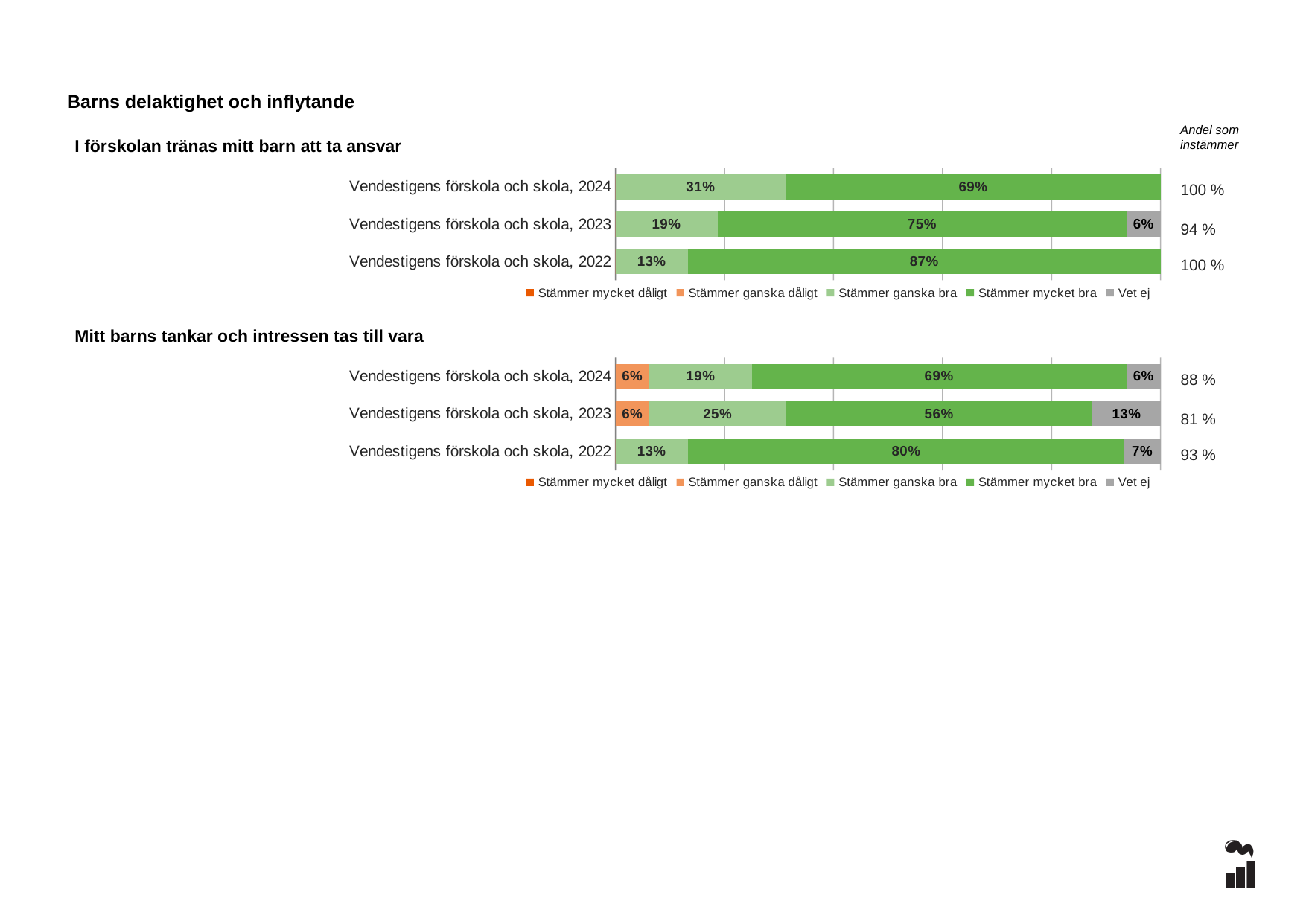
How many series does the legend of the chart 'I förskolan tränas mitt barn att ta ansvar' list? 5 In the chart 'I förskolan tränas mitt barn att ta ansvar', what is the 'Vet ej' value for Vendestigens förskola och skola, 2023? 6% In the chart 'Mitt barns tankar och intressen tas till vara', what is the 'Andel som instämmer' for Vendestigens förskola och skola, 2023? 81 % What kind of chart is 'Mitt barns tankar och intressen tas till vara'? Stacked bar chart In the chart 'Mitt barns tankar och intressen tas till vara', which year has the lowest 'Stämmer mycket bra' value? 2023 In the chart 'I förskolan tränas mitt barn att ta ansvar', what is the 'Stämmer mycket bra' value for Vendestigens förskola och skola, 2022? 87% In the chart 'I förskolan tränas mitt barn att ta ansvar', which year has the highest 'Stämmer mycket bra' value? 2022 In the chart 'Mitt barns tankar och intressen tas till vara', is the 'Vet ej' value for 2023 larger or smaller than the 'Vet ej' value for 2022? larger In the chart 'Mitt barns tankar och intressen tas till vara', what is the 'Stämmer mycket bra' value for Vendestigens förskola och skola, 2023? 56% In the chart 'Mitt barns tankar och intressen tas till vara', what is the 'Stämmer ganska dåligt' value for Vendestigens förskola och skola, 2024? 6% In the chart 'I förskolan tränas mitt barn att ta ansvar', what is the difference between the 'Stämmer mycket bra' values for 2023 and 2024? 6% In the chart 'I förskolan tränas mitt barn att ta ansvar', what is the 'Stämmer ganska bra' value for Vendestigens förskola och skola, 2024? 31%